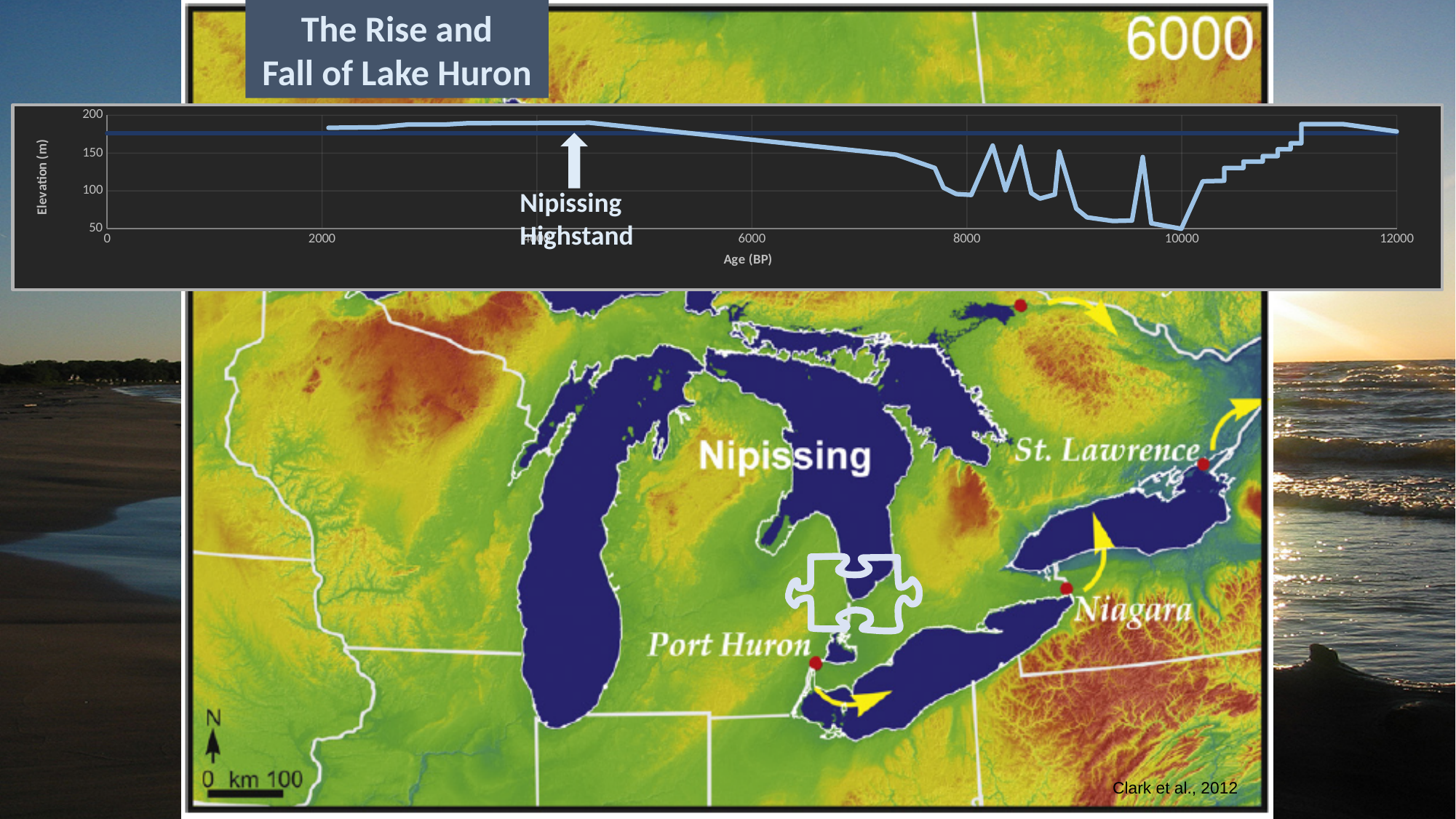
Does the light blue elevation line rise or fall as age increases from 6000 BP to 8000 BP? fall Which has the higher elevation on the light blue line, 6000 BP or 8000 BP? 6000 BP What is the title of the y axis of the chart? Elevation (m) Is the elevation value at 8000 BP greater or less than 150? less What kind of chart is shown on the slide? line chart Is the elevation value at 12000 BP greater or less than 150? greater What is the title of the x axis of the chart? Age (BP) Is the elevation value at 2000 BP greater or less than 150? greater Does the light blue elevation line rise or fall as age increases from 10000 BP to 11000 BP? rise Which has the higher elevation on the light blue line, 2000 BP or 10000 BP? 2000 BP